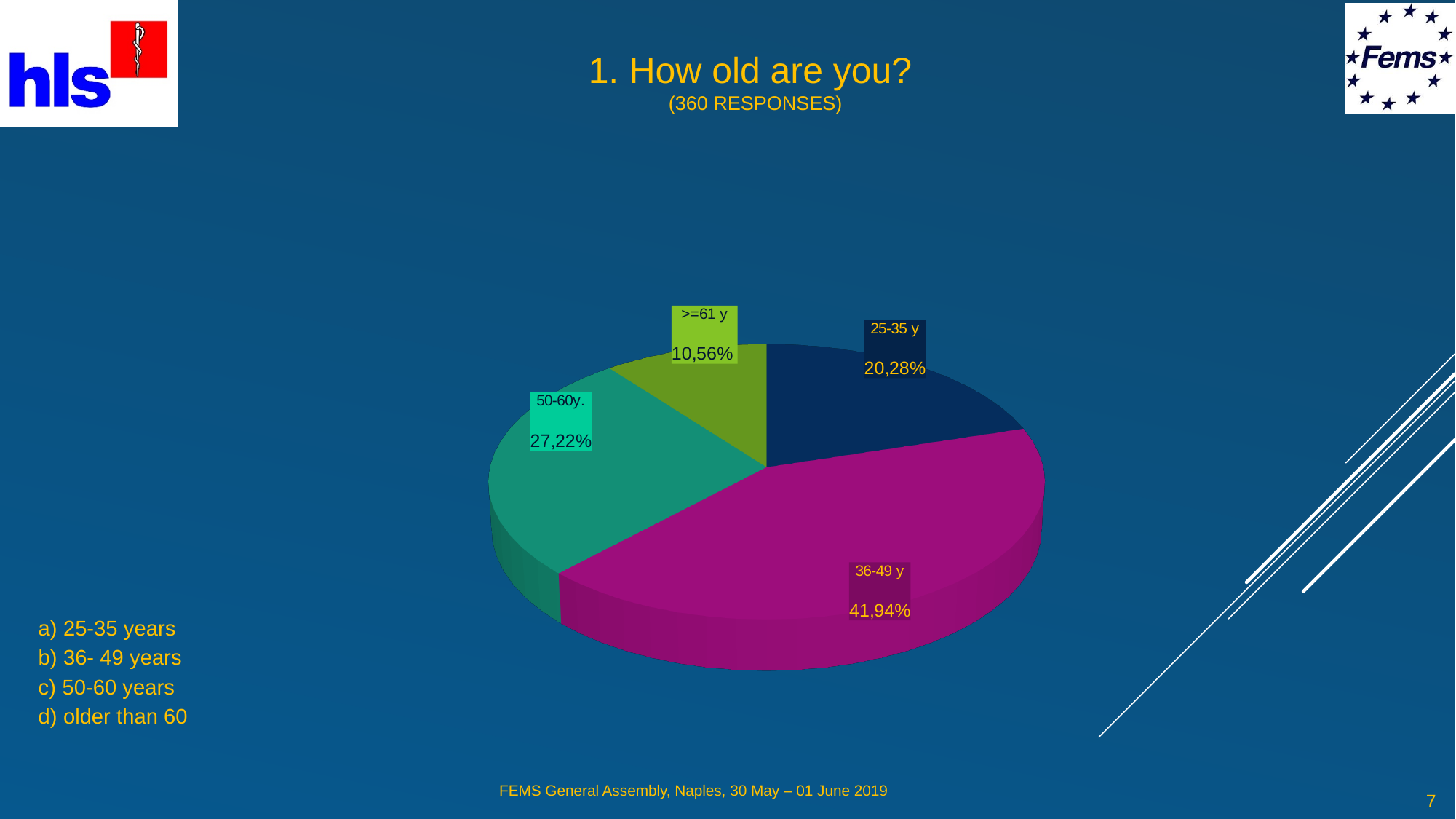
Which age group has the smallest share of the pie? >=61 y What share of respondents are in the 36-49 y age group? 41,94% How many responses does the chart subtitle say were collected? 360 What is the title of the chart on the slide? 1. How old are you? What share of respondents are in the >=61 y age group? 10,56% How many slices does the pie chart have? 4 What is the difference in percentage points between the 36-49 y share and the 50-60y. share? 14,72 What share of respondents are in the 50-60y. age group? 27,22% Which is larger, the share for 50-60y. or the share for 25-35 y? 50-60y. What share of respondents are in the 25-35 y age group? 20,28% What kind of chart is shown on the slide? pie chart Which age group has the largest share of the pie? 36-49 y